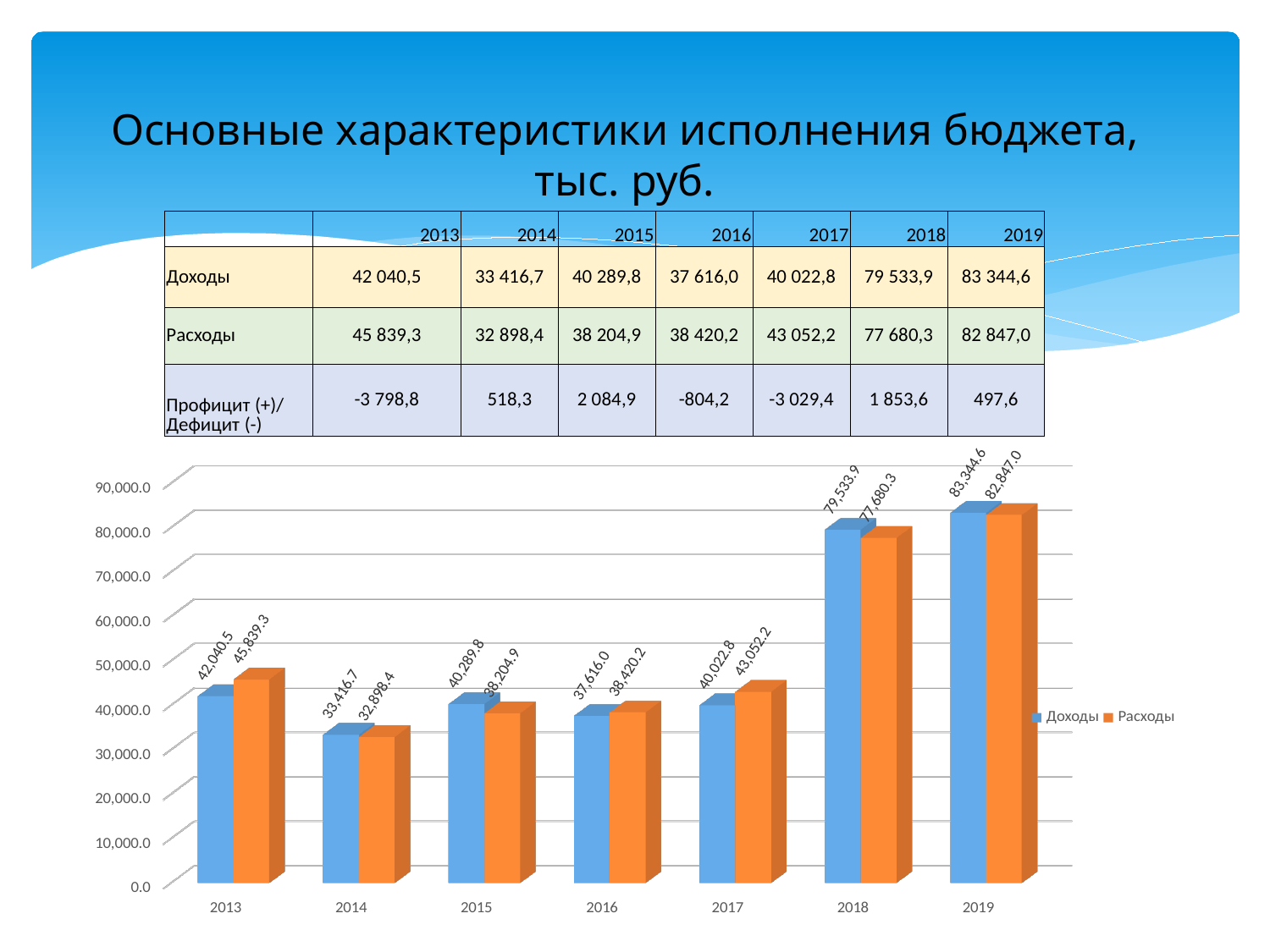
How many years are shown on the x axis of the chart? 7 What is the value of Доходы for 2013 in the chart? 42,040.5 What is the value of Доходы for 2018 in the chart? 79,533.9 How many series does the chart legend list? 2 What is the difference between Доходы and Расходы for 2019 in the chart? 497.6 What is the value of Расходы for 2017 in the chart? 43,052.2 What type of chart is shown on the slide? Bar chart In 2016, which is larger in the chart: Доходы or Расходы? Расходы Which year has the highest Доходы value in the chart? 2019 Which year has the lowest Расходы value in the chart? 2014 Is the value of Расходы for 2018 greater or less than 70,000.0? greater What is the difference between Расходы and Доходы for 2013 in the chart? 3,798.8